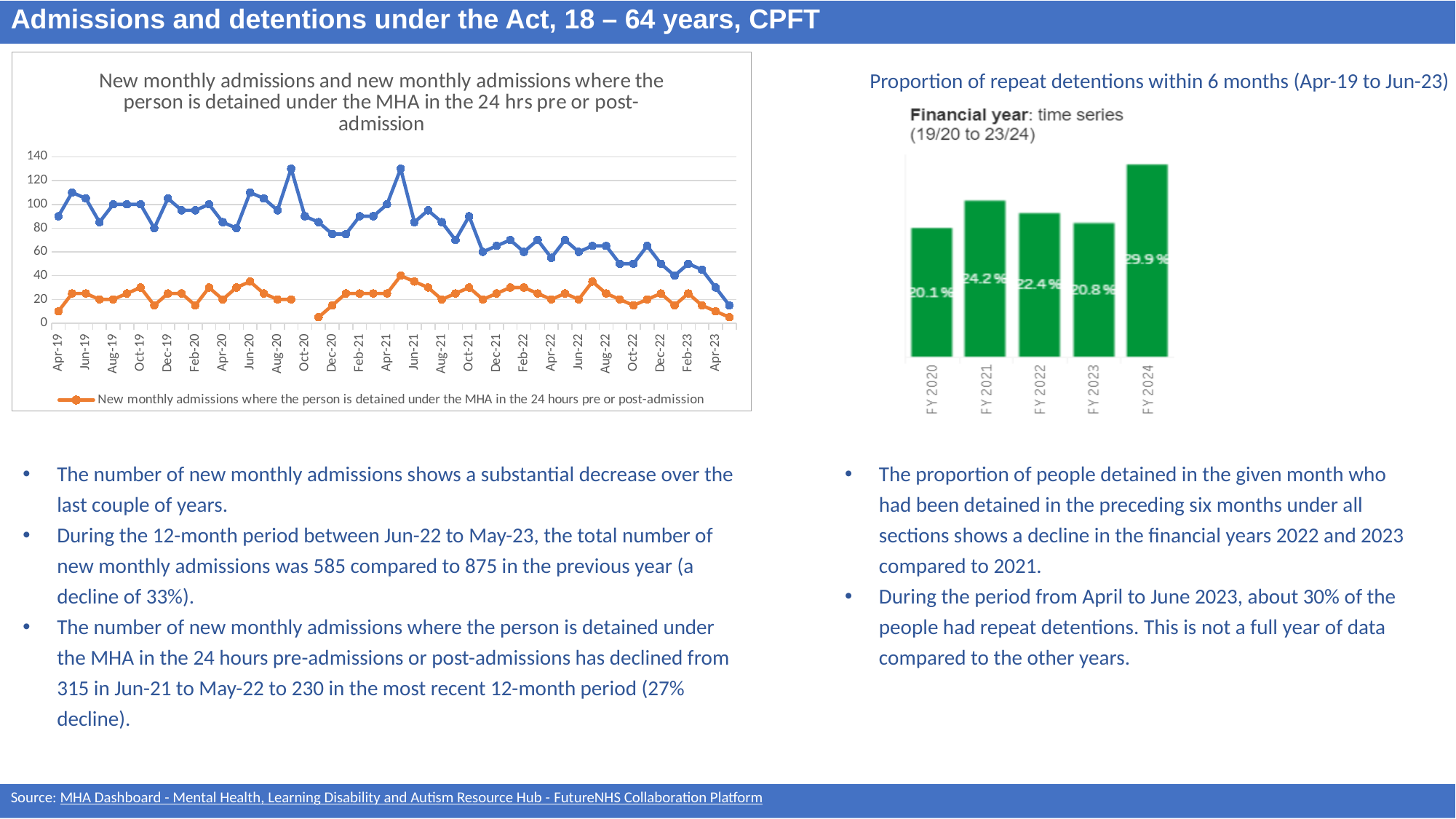
In the 'Proportion of repeat detentions within 6 months' chart, which financial year has the lowest proportion? FY 2020 In the 'Proportion of repeat detentions within 6 months' chart, what is the value for FY 2021? 24.2% In the 'Proportion of repeat detentions within 6 months' chart, which financial year has the highest proportion? FY 2024 What kind of chart is the 'Proportion of repeat detentions within 6 months' chart? Bar chart In the 'Proportion of repeat detentions within 6 months' chart, what is the difference in percentage points between FY 2024 and FY 2020? 9.8 percentage points In the 'Proportion of repeat detentions within 6 months' chart, which is larger, the value for FY 2022 or FY 2023? FY 2022 In the left chart, is the value of the blue line (new monthly admissions) for Apr-23 greater or less than 20? greater How many lines are plotted in the left chart showing new monthly admissions? 2 How many financial years are shown in the 'Proportion of repeat detentions within 6 months' chart? 5 In the 'Proportion of repeat detentions within 6 months' chart, what is the value for FY 2024? 29.9% What kind of chart is the chart on the left of the slide showing new monthly admissions? Line chart In the left chart, does the blue line for new monthly admissions generally rise or fall from Apr-19 to Apr-23? Fall